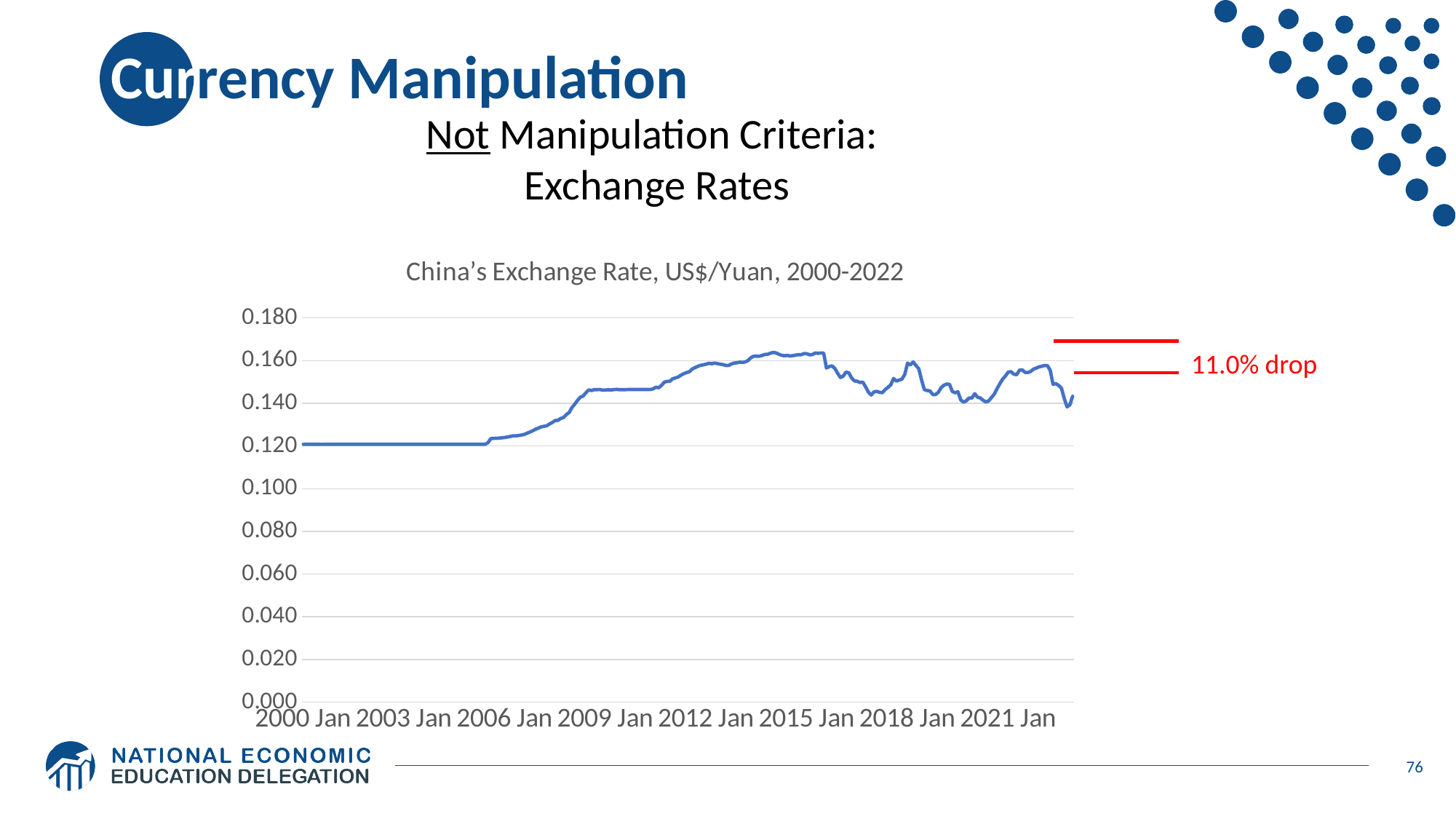
What is the highest value labelled on the y axis? 0.180 What percentage drop is annotated in red on the chart? 11.0% drop Is the exchange rate in 2003 Jan greater or less than 0.140? less What is the title of the chart? China's Exchange Rate, US$/Yuan, 2000-2022 Is the exchange rate in 2015 Jan greater or less than 0.140? greater Which is larger, the exchange rate in 2003 Jan or in 2012 Jan? 2012 Jan How many year labels are shown on the x axis? 8 Does the exchange rate rise or fall between 2006 Jan and 2012 Jan? rise What kind of chart is shown on the slide? line chart Does the exchange rate rise or fall between 2015 Jan and the end of the series in 2022? fall Is the exchange rate in 2012 Jan greater or less than 0.140? greater